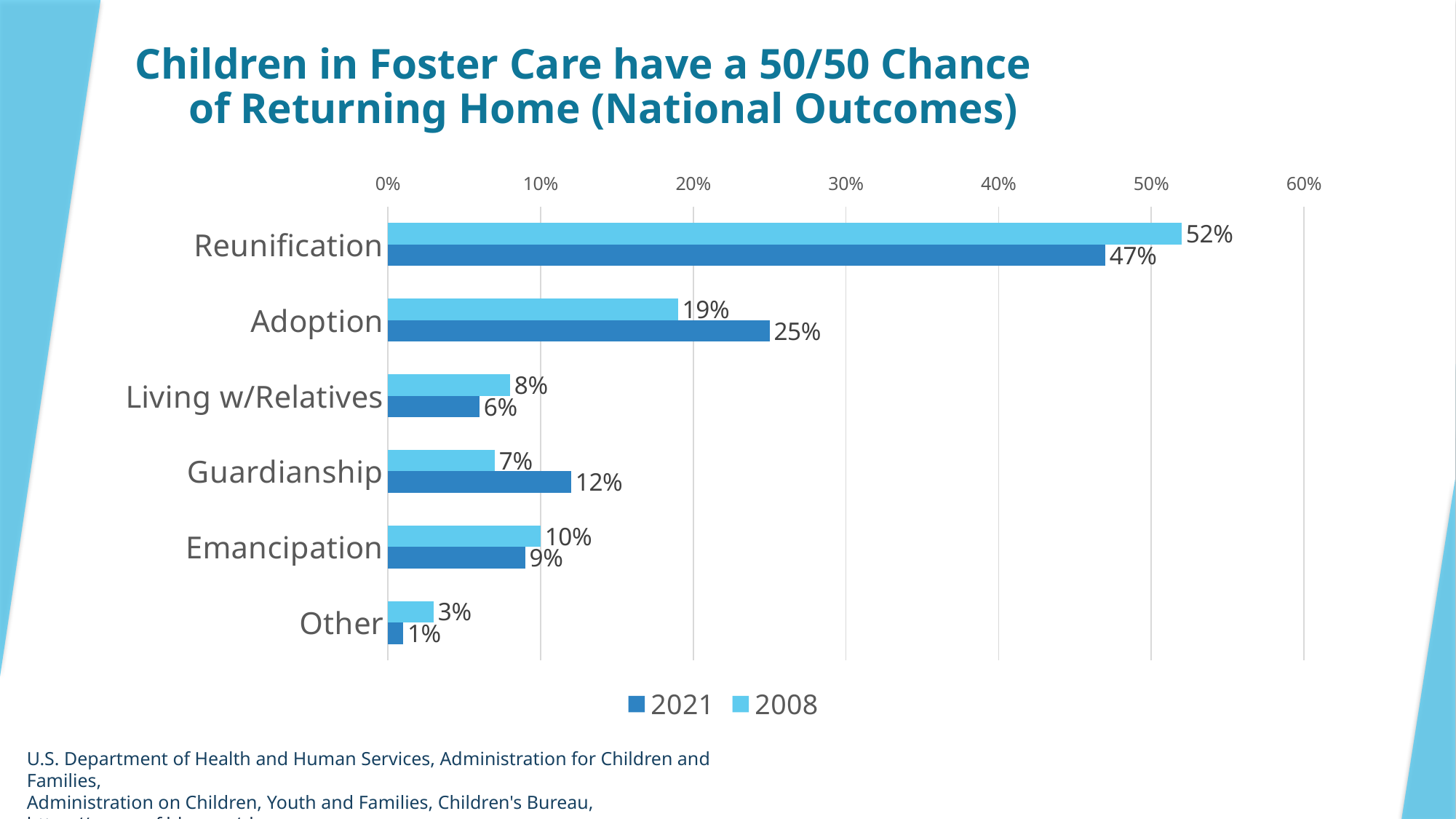
What kind of chart is shown on the slide? Bar chart What is the difference between the 2008 and 2021 values for Reunification? 5% What is the difference between the 2021 and 2008 values for Adoption? 6% What is the 2021 value for Reunification? 47% Which category has the highest 2008 value? Reunification Which is larger for Guardianship, the 2021 value or the 2008 value? 2021 Which category has the lowest 2021 value? Other What is the 2008 value for Adoption? 19% Is the 2021 value for Adoption greater or less than 20%? greater What is the 2021 value for Guardianship? 12% How many categories are shown on the chart? 6 How many series does the legend list? 2